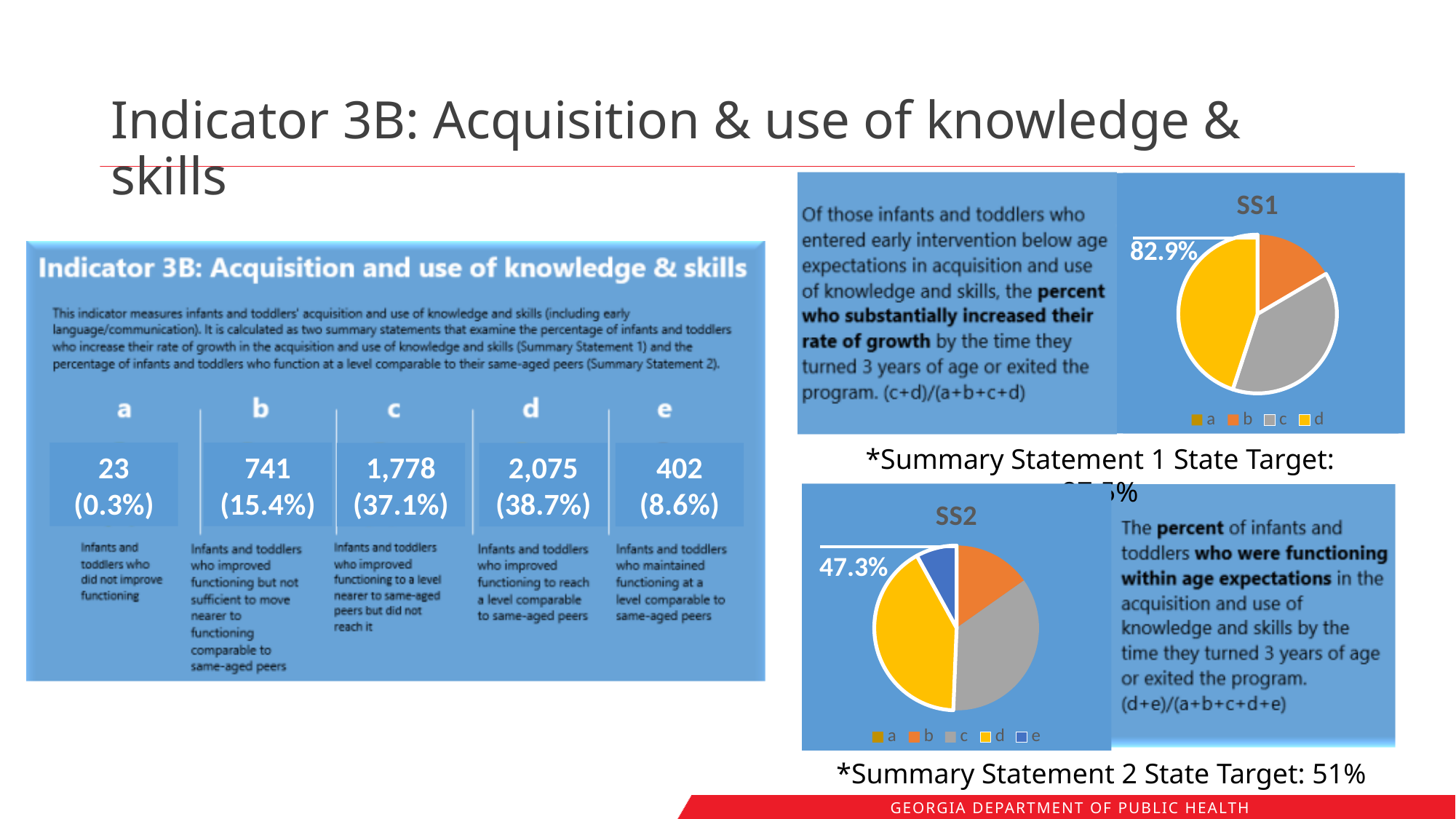
What kind of chart is the SS1 chart? Pie chart What colour represents category d in the SS2 chart? Yellow In the SS2 chart, which slice is larger, b or e? b How many categories does the legend of the SS2 chart list? 5 How many categories does the legend of the SS1 chart list? 4 What is the title of the lower pie chart on the slide? SS2 What percentage value is printed on the SS2 chart? 47.3% What percentage value is printed on the SS1 chart? 82.9% In the SS1 chart, which slice is larger, b or c? c In the SS1 chart, which category has the smallest slice? a In the SS1 chart, which category has the largest slice? d In the SS2 chart, which slice is larger, c or b? c